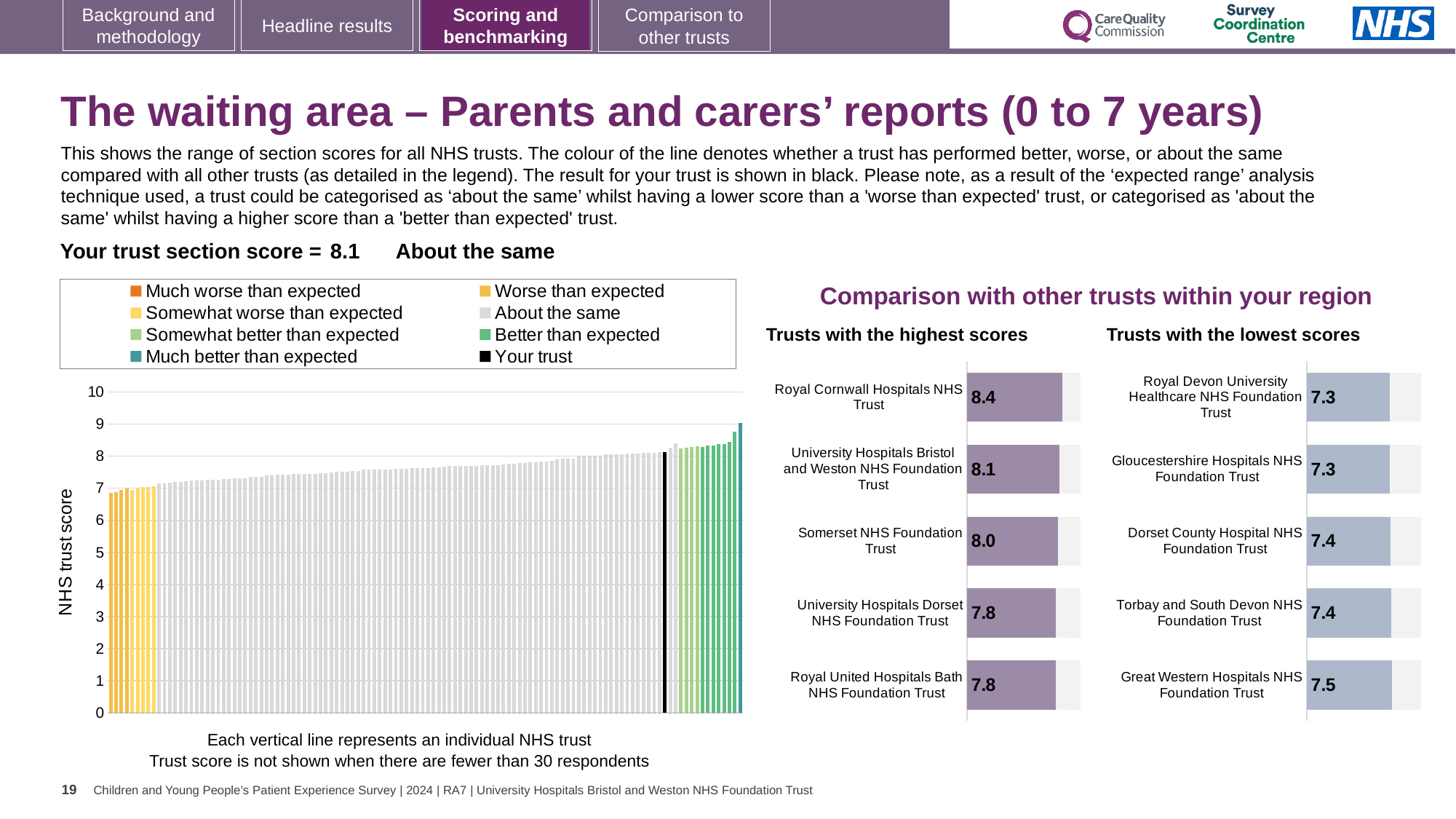
In the 'Trusts with the highest scores' chart, what is the score for Royal Cornwall Hospitals NHS Trust? 8.4 In the 'Trusts with the lowest scores' chart, which trust has the highest score shown? Great Western Hospitals NHS Foundation Trust How many entries does the legend of the main 'NHS trust score' chart on the left list? 8 In the main 'NHS trust score' chart on the left, is the value for the lowest-scoring trust greater or less than 7? less In the 'Trusts with the highest scores' chart, what is the difference between the scores of Royal Cornwall Hospitals NHS Trust and Royal United Hospitals Bath NHS Foundation Trust? 0.6 In the 'Trusts with the lowest scores' chart, what is the score for Great Western Hospitals NHS Foundation Trust? 7.5 In the main 'NHS trust score' chart on the left, do the trust scores rise or fall from left to right? rise In the 'Trusts with the lowest scores' chart, what is the difference between the scores of Great Western Hospitals NHS Foundation Trust and Gloucestershire Hospitals NHS Foundation Trust? 0.2 How many trusts are listed in the 'Trusts with the lowest scores' chart? 5 In the 'Trusts with the highest scores' chart, which has the larger score: Royal Cornwall Hospitals NHS Trust or Somerset NHS Foundation Trust? Royal Cornwall Hospitals NHS Trust In the 'Trusts with the highest scores' chart, which trust has the highest score? Royal Cornwall Hospitals NHS Trust In the 'Trusts with the highest scores' chart, what is the score for Somerset NHS Foundation Trust? 8.0